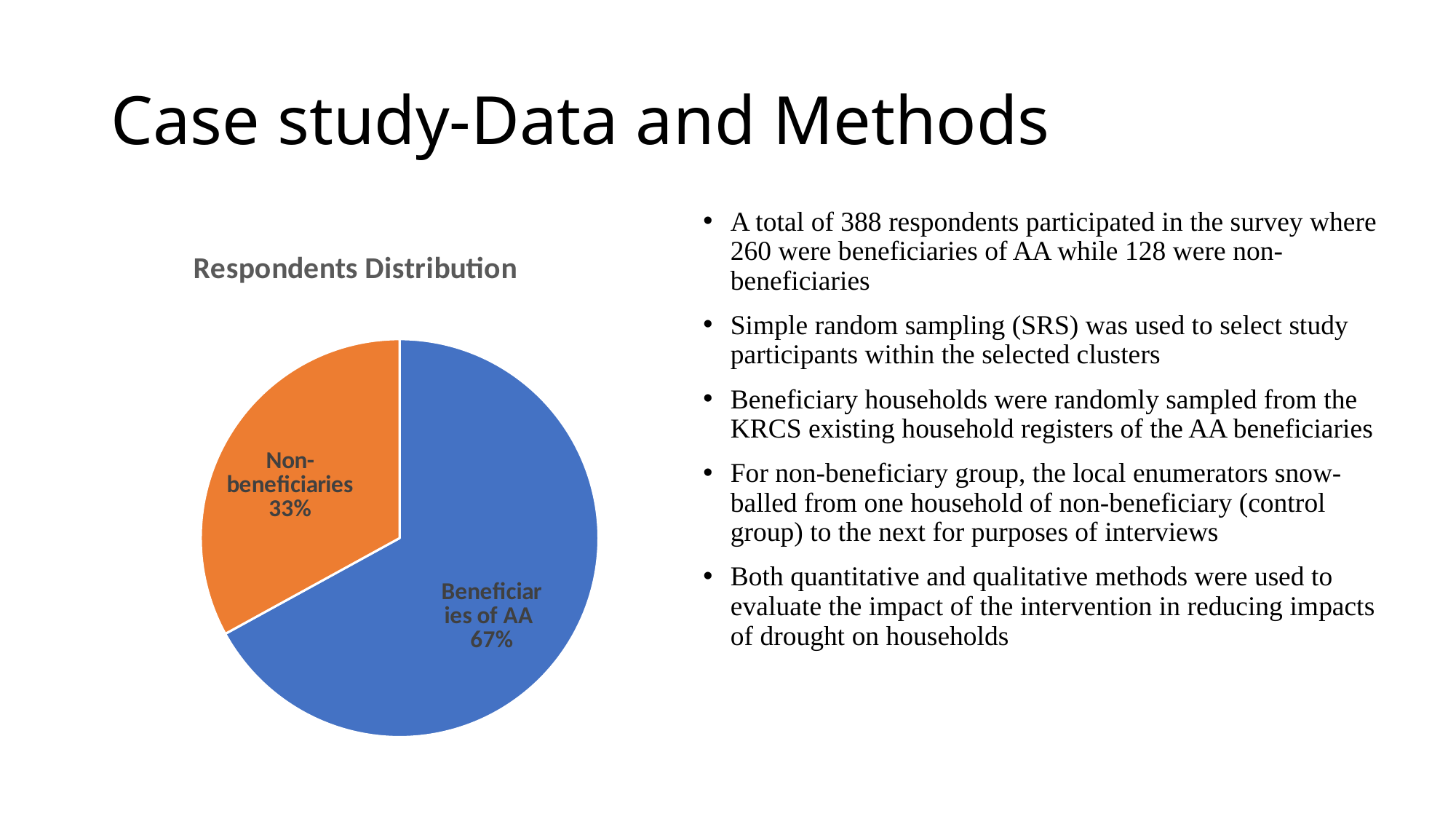
Which slice of the pie is the smallest? Non-beneficiaries What type of chart is shown on the slide? pie chart Which is larger, the Beneficiaries of AA slice or the Non-beneficiaries slice? Beneficiaries of AA Which slice of the pie is the largest? Beneficiaries of AA How many slices does the pie chart have? 2 What colour is the Non-beneficiaries slice? orange What is the difference in percentage points between the Beneficiaries of AA slice and the Non-beneficiaries slice? 34 percentage points What is the title of the chart? Respondents Distribution What share of the pie is labelled Beneficiaries of AA? 67% What share of the pie is labelled Non-beneficiaries? 33%